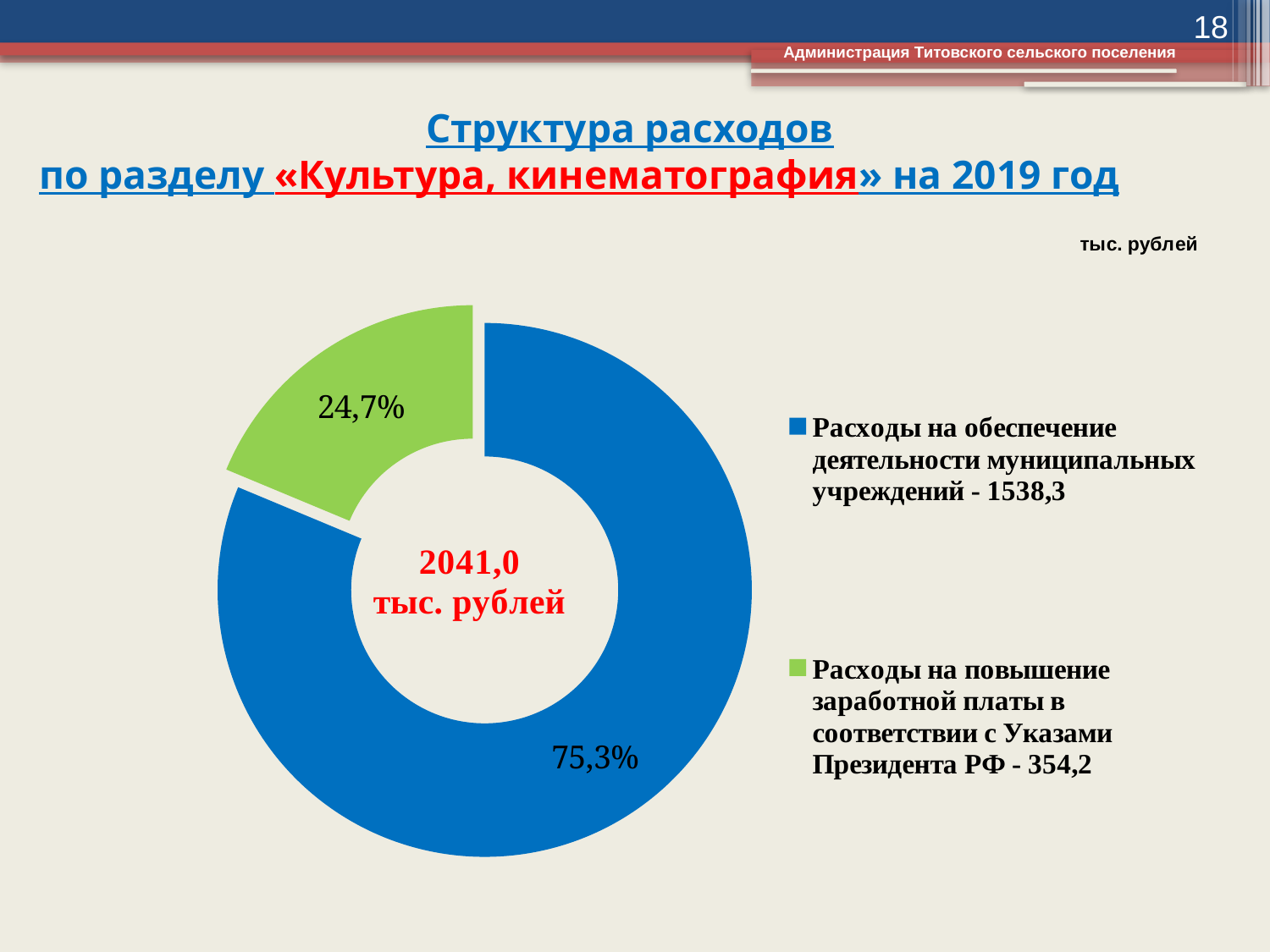
Which category has the smallest slice of the chart? Расходы на повышение заработной платы в соответствии с Указами Президента РФ What is the difference between the two values shown in the legend, 1538,3 and 354,2? 1184,1 Which is larger: the slice for «Расходы на обеспечение деятельности муниципальных учреждений» or the slice for «Расходы на повышение заработной платы»? Расходы на обеспечение деятельности муниципальных учреждений What is the value shown in the legend for «Расходы на обеспечение деятельности муниципальных учреждений»? 1538,3 What kind of chart is shown on the slide? doughnut chart What share of the chart does the slice for «Расходы на обеспечение деятельности муниципальных учреждений» represent? 75,3% Which category has the largest slice of the chart? Расходы на обеспечение деятельности муниципальных учреждений By how many percentage points does the 75,3% slice exceed the 24,7% slice? 50,6 What share of the chart does the slice for «Расходы на повышение заработной платы в соответствии с Указами Президента РФ» represent? 24,7% How many categories does the chart show? 2 What total amount is printed in the centre of the chart? 2041,0 тыс. рублей What is the value shown in the legend for «Расходы на повышение заработной платы в соответствии с Указами Президента РФ»? 354,2